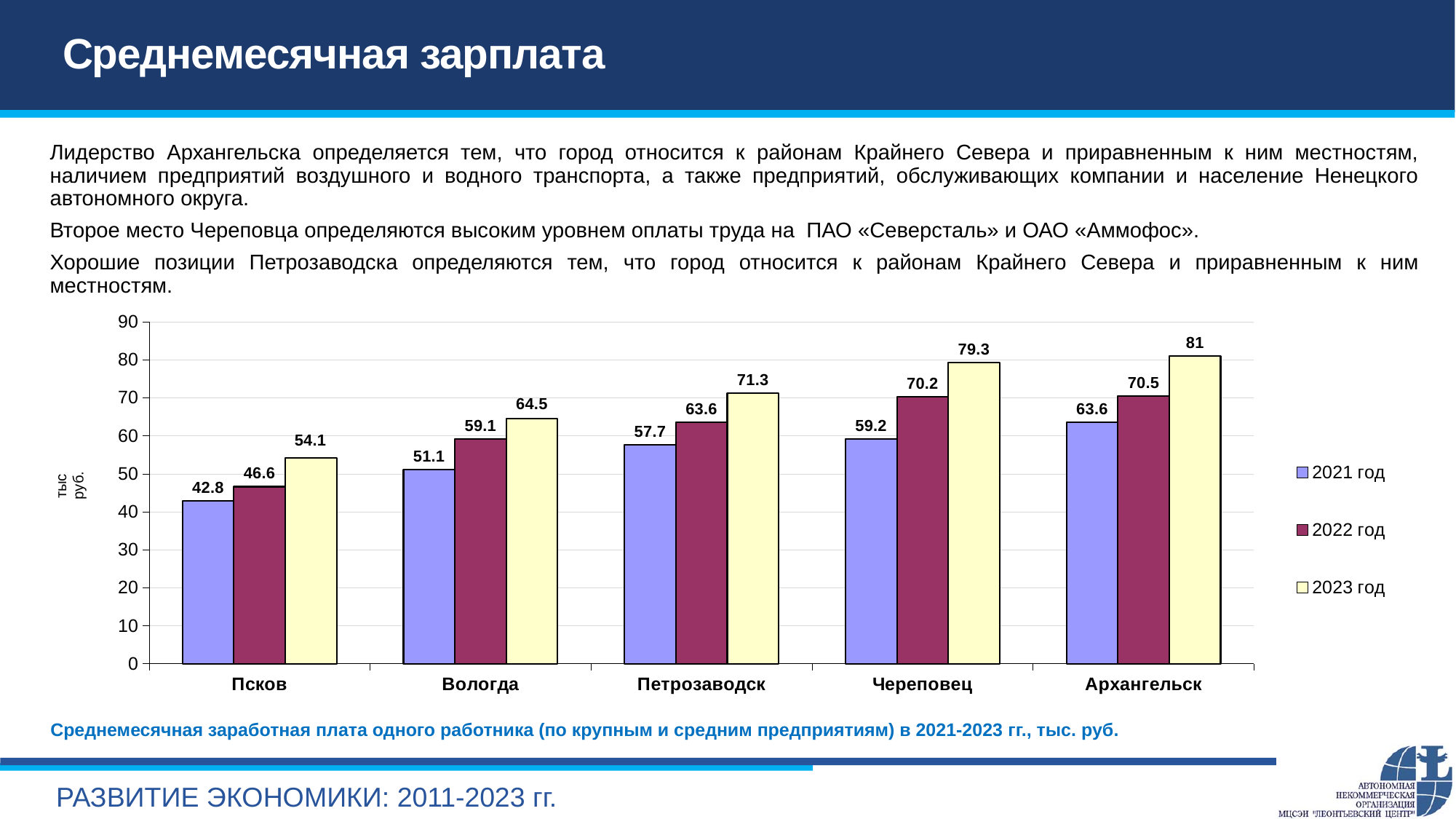
How many cities are shown on the x axis? 5 What is the difference between the 2023 год and 2021 год values for Петрозаводск? 13.6 How many series does the legend list? 3 What kind of chart is shown on the slide? bar chart What unit is shown on the y axis label? тыс. руб. What is the value for Псков in 2021 год? 42.8 Is the 2021 год value for Вологда greater or less than 60? less Which city has the lowest value in 2022 год? Псков What is the value for Вологда in 2022 год? 59.1 What is the value for Череповец in 2023 год? 79.3 Which is larger: the 2022 год value for Череповец or the 2022 год value for Архангельск? Архангельск Which city has the highest value in 2023 год? Архангельск